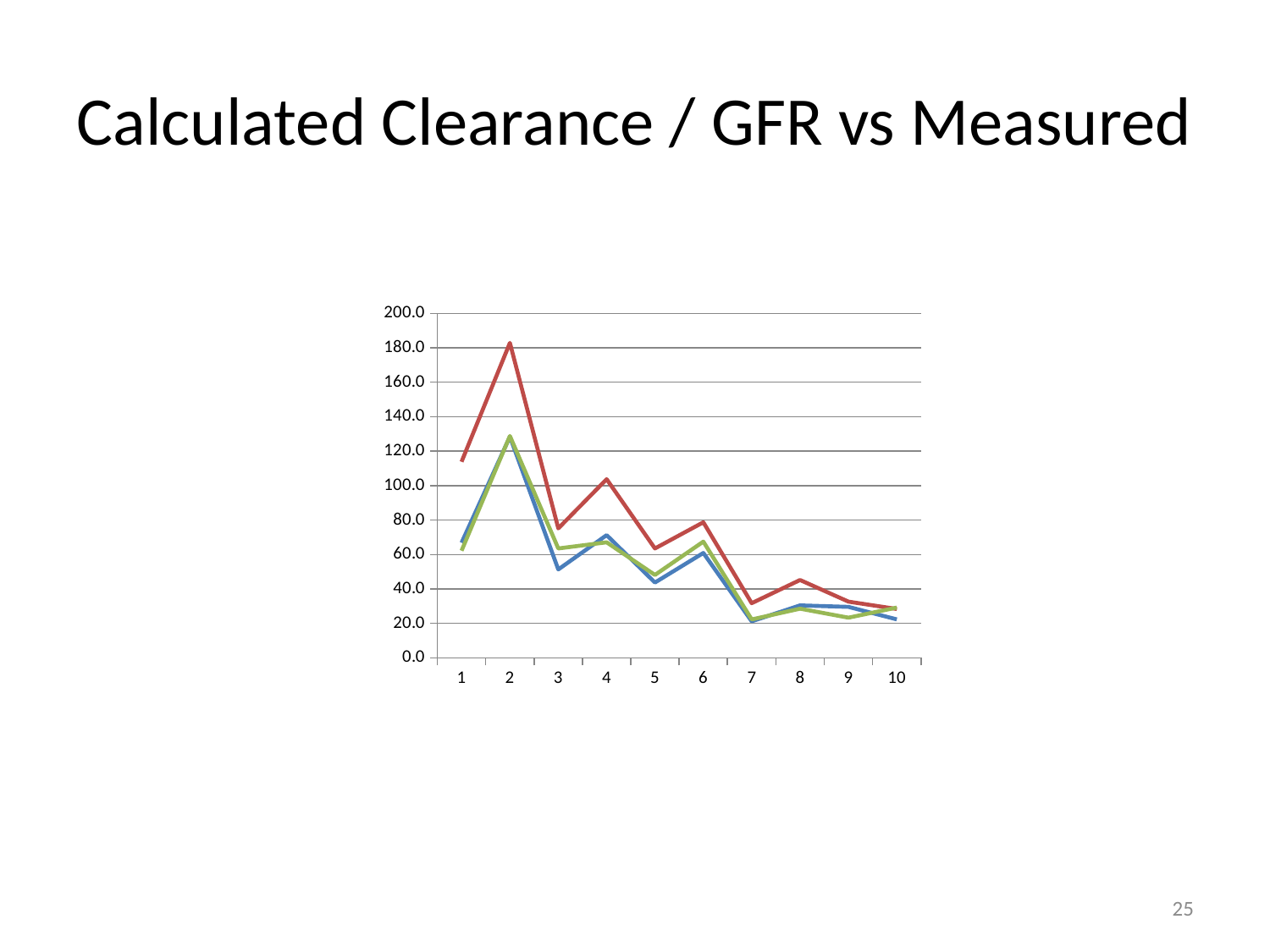
What is the title of the slide containing the chart? Calculated Clearance / GFR vs Measured How many points are plotted along the x axis? 10 How many lines are plotted on the chart? 3 Is the value of the red line at x = 2 greater or less than 160? greater What kind of chart is shown on the slide? line chart Overall, does the red line rise or fall from x = 1 to x = 10? fall At which x-axis value does the red line reach its highest point? 2 Is the value of the blue line at x = 2 greater or less than 100? greater At x = 4, which line has the larger value, the red line or the blue line? red line Is the value of the green line at x = 5 greater or less than 60? less